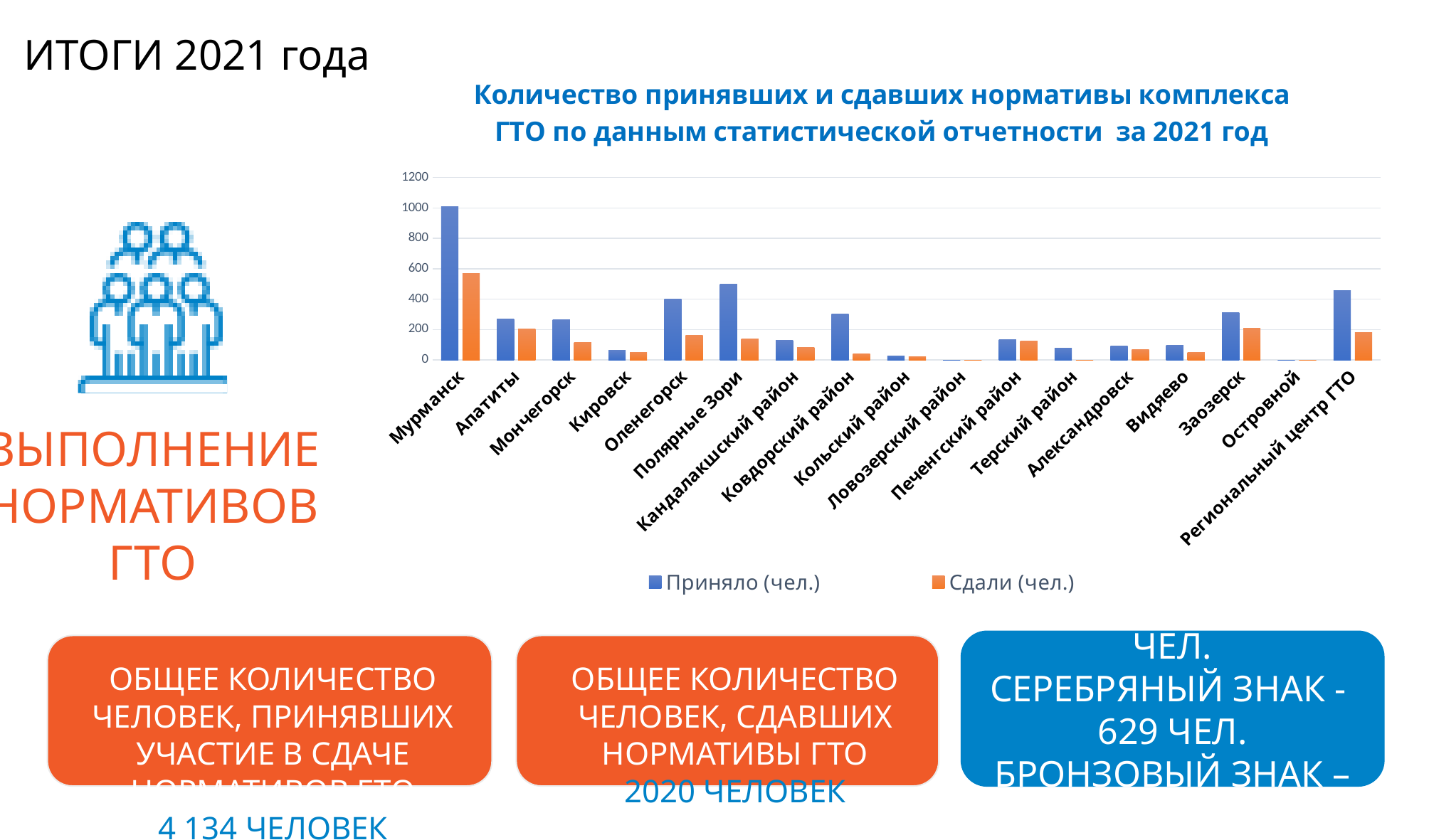
Which category has the highest value for the series Приняло (чел.)? Мурманск Is the value of Приняло (чел.) for Региональный центр ГТО greater or less than 400? greater How many series does the chart legend list? 2 Which category has the highest value for the series Сдали (чел.)? Мурманск Is the value of Приняло (чел.) for Мурманск greater or less than 800? greater Which has a larger value for Приняло (чел.): Полярные Зори or Оленегорск? Полярные Зори Which has a larger value for Сдали (чел.): Апатиты or Кировск? Апатиты Is the value of Приняло (чел.) for Кировск greater or less than 200? less How many categories (municipalities) are shown on the x axis of the chart? 17 What kind of chart is shown on the slide? bar chart What are the two series named in the chart legend? Приняло (чел.) and Сдали (чел.)